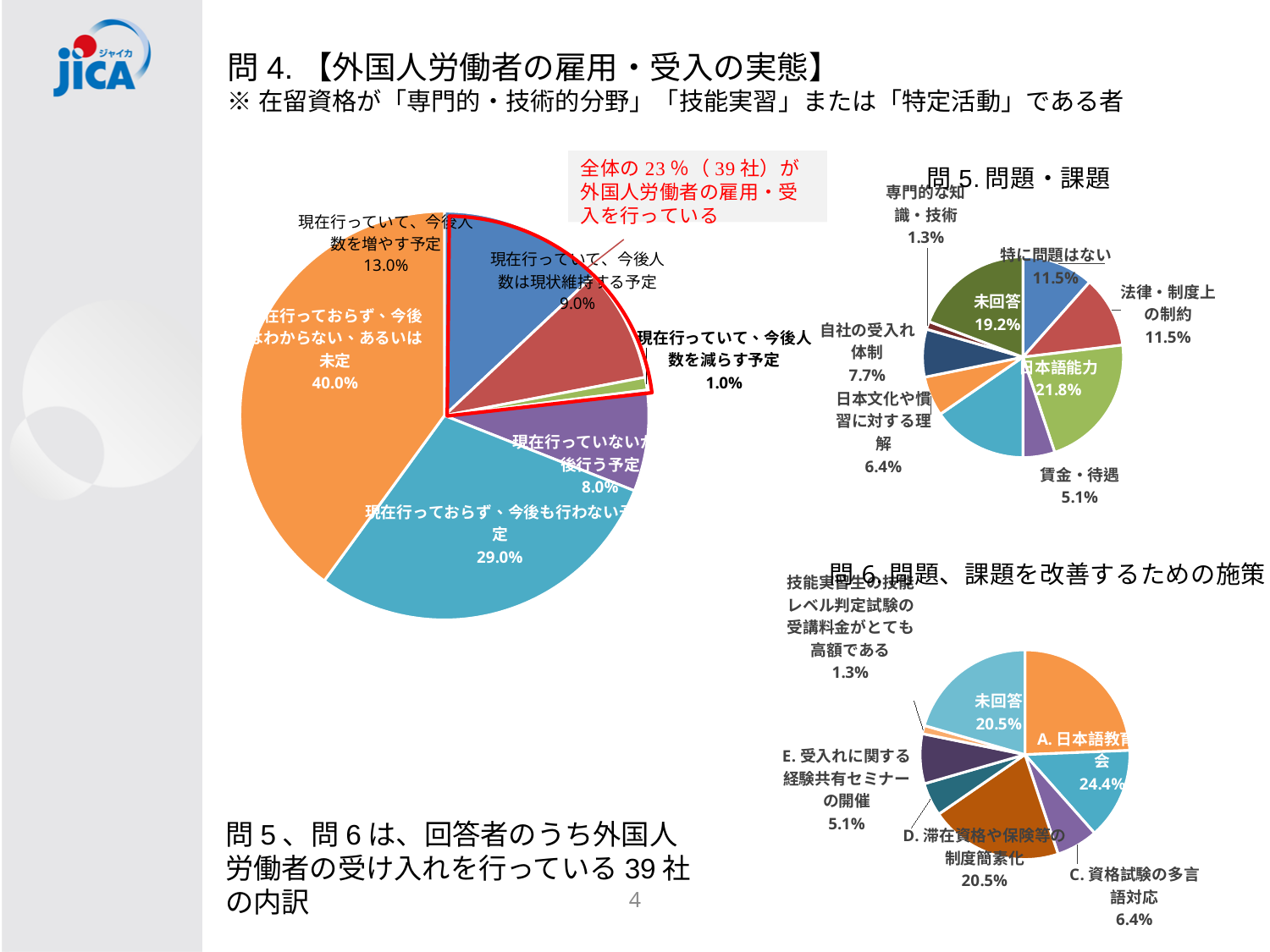
問4の円グラフで、最も割合が大きい項目はどれですか？ 現在行っておらず、今後はわからない、あるいは未定 問5「問題・課題」の円グラフで、「未回答」の割合はいくつですか？ 19.2% 問5「問題・課題」の円グラフで、「日本語能力」の割合はいくつですか？ 21.8% このスライドの問6のグラフはどの種類のグラフですか？ 円グラフ 問6の円グラフで、「A. 日本語教育の機会」の割合はいくつですか？ 24.4% 問4の円グラフで、「現在行っておらず、今後はわからない、あるいは未定」の割合はいくつですか？ 40.0% 問4の円グラフで、「現在行っていないが今後行う予定」と「現在行っていて、今後人数は現状維持する予定」では、どちらの割合が大きいですか？ 現在行っていて、今後人数は現状維持する予定 問4の円グラフで、「現在行っていて、今後人数を増やす予定」と「現在行っていて、今後人数は現状維持する予定」の割合の差はいくつですか？ 4.0% 問5「問題・課題」の円グラフで、ラベルのある項目のうち最も割合が小さいものはどれですか？ 専門的な知識・技術 問4の円グラフで、最も割合が小さい項目はどれですか？ 現在行っていて、今後人数を減らす予定 問4の円グラフで、「現在行っておらず、今後も行わない予定」の割合はいくつですか？ 29.0% 問6の円グラフで、「D. 滞在資格や保険等の制度簡素化」と「C. 資格試験の多言語対応」の割合の差はいくつですか？ 14.1%